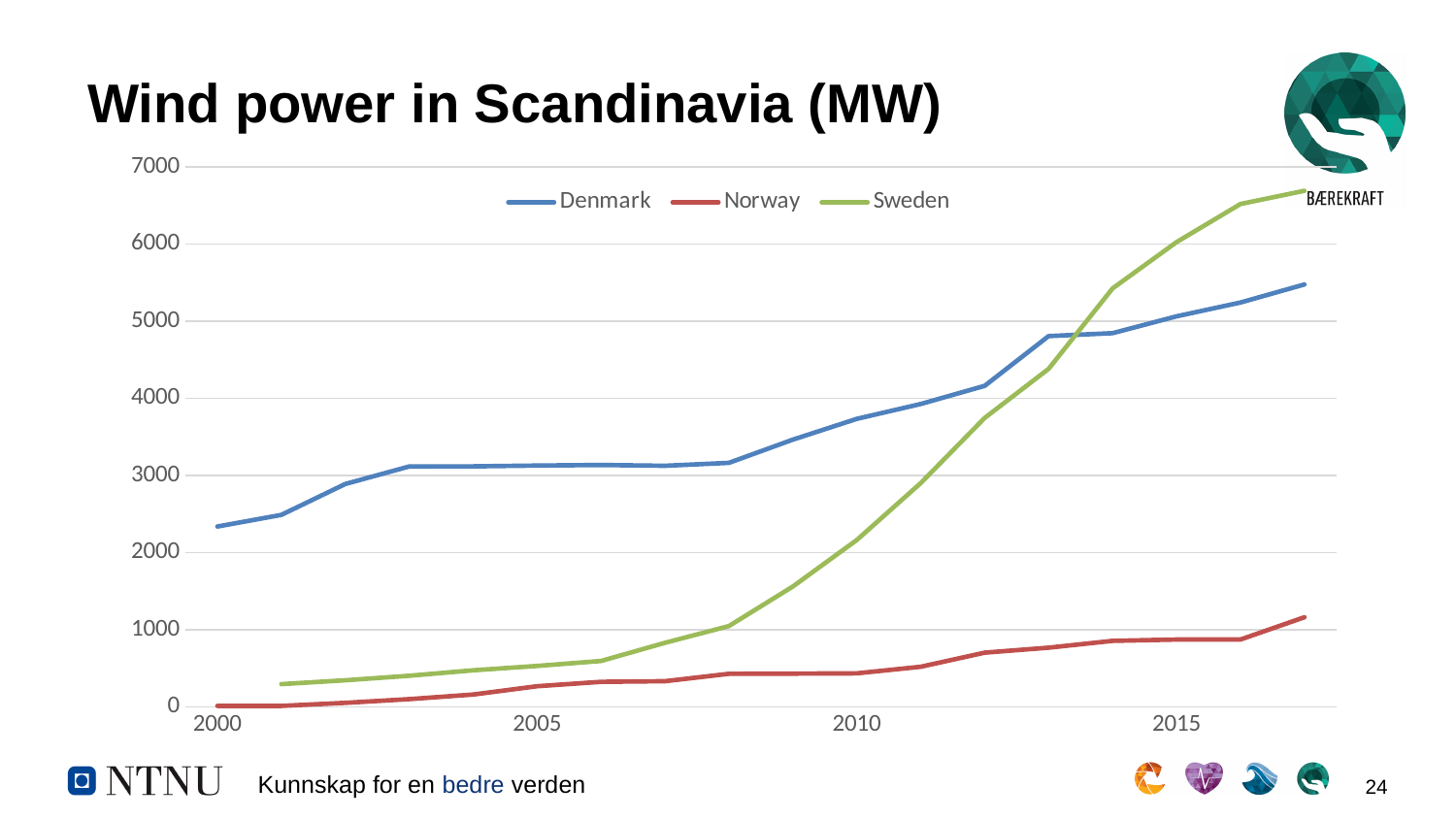
Which country has the highest wind power value in 2005? Denmark How many series does the legend list? 3 In 2010, which is larger: the value for Denmark or the value for Sweden? Denmark Which country has the highest wind power value at the end of the series (2017)? Sweden What is the title of the chart? Wind power in Scandinavia (MW) Is the value for Norway in 2017 greater or less than 1000? greater Which country has the lowest wind power value in 2017? Norway What kind of chart is shown on the slide? line chart Is the value for Denmark in 2000 greater or less than 2000? greater Is the value for Sweden in 2010 greater or less than 3000? less Does the value for Sweden rise or fall from 2001 to 2017? rise Which countries are listed in the chart's legend? Denmark, Norway, Sweden